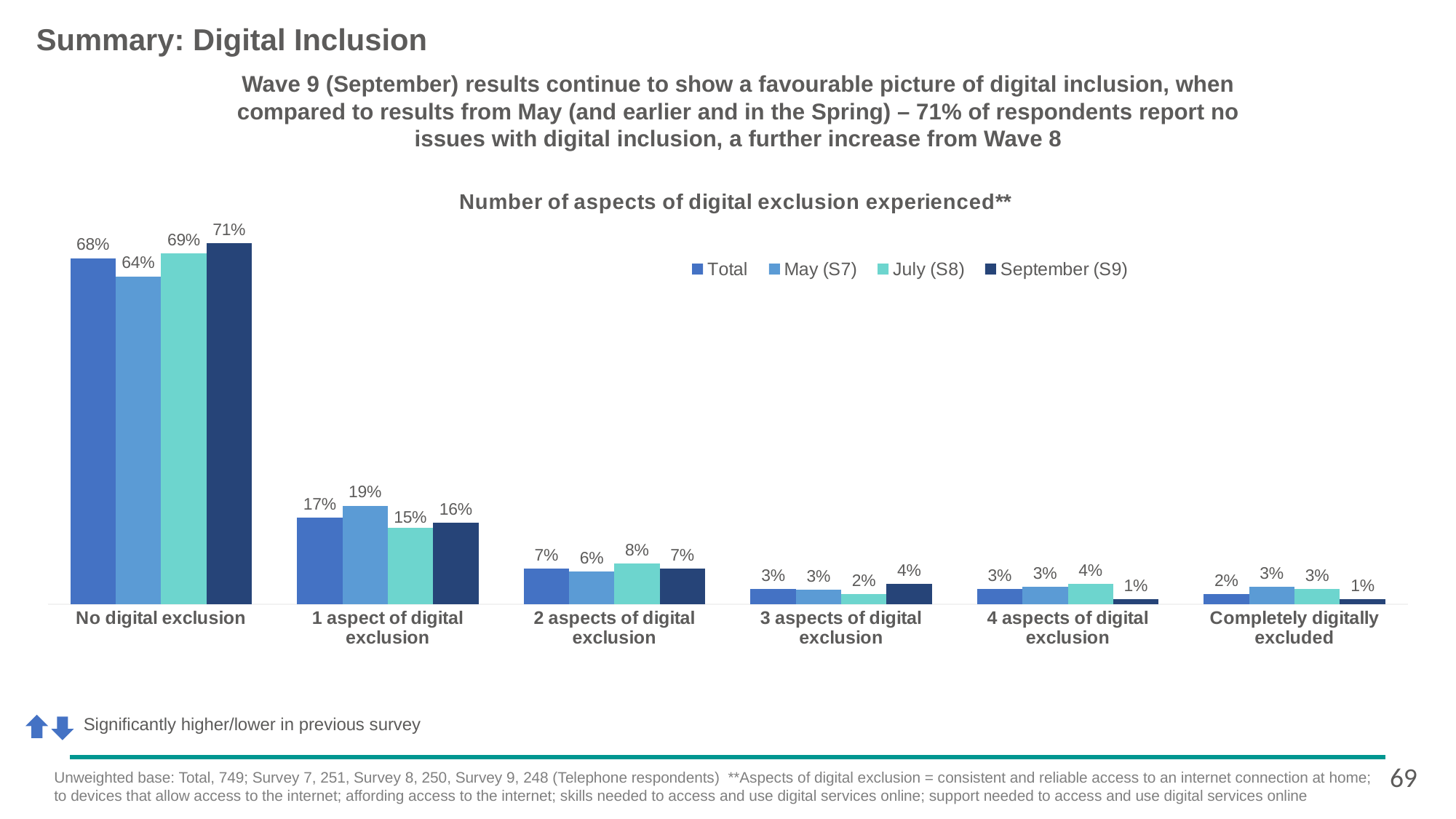
Which category has the highest September (S9) value? No digital exclusion What is the July (S8) value for 2 aspects of digital exclusion? 8% What is the September (S9) value for No digital exclusion? 71% What is the title of the chart? Number of aspects of digital exclusion experienced** What is the difference between the September (S9) and May (S7) values for No digital exclusion? 7% What is the Total value for Completely digitally excluded? 2% How many categories are shown on the x axis? 6 What kind of chart is shown? Bar chart How many series does the legend list? 4 Which is larger for 3 aspects of digital exclusion: the July (S8) value or the September (S9) value? September (S9) What is the May (S7) value for 1 aspect of digital exclusion? 19%